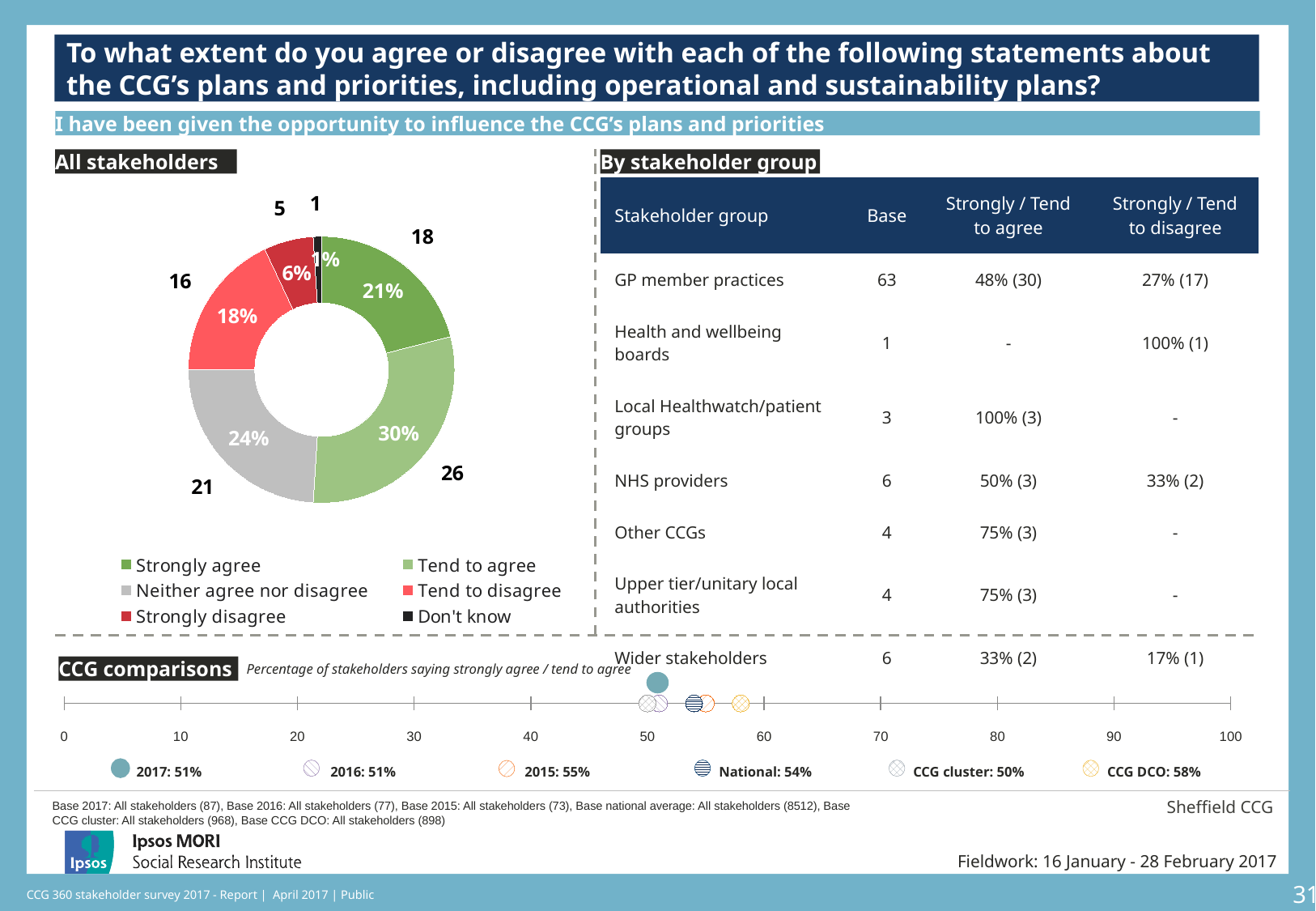
In the All stakeholders chart, what percentage of stakeholders said 'Strongly disagree'? 6% In the All stakeholders chart, what is the difference in percentage points between 'Tend to agree' and 'Strongly agree'? 9 percentage points In the All stakeholders chart, what percentage of stakeholders said 'Tend to agree'? 30% What kind of chart is the All stakeholders chart? Pie (donut) chart How many response categories are shown in the All stakeholders chart? 6 In the All stakeholders chart, what colour represents 'Neither agree nor disagree'? Grey In the CCG comparisons chart, what percentage is shown for 2015? 55% In the All stakeholders chart, which response category has the largest share? Tend to agree In the All stakeholders chart, which response category has the smallest share? Don't know In the All stakeholders chart, which is larger: 'Neither agree nor disagree' or 'Tend to disagree'? Neither agree nor disagree In the All stakeholders chart, what is the combined share of 'Strongly agree' and 'Tend to agree'? 51% In the CCG comparisons chart, which comparator has the highest percentage? CCG DCO